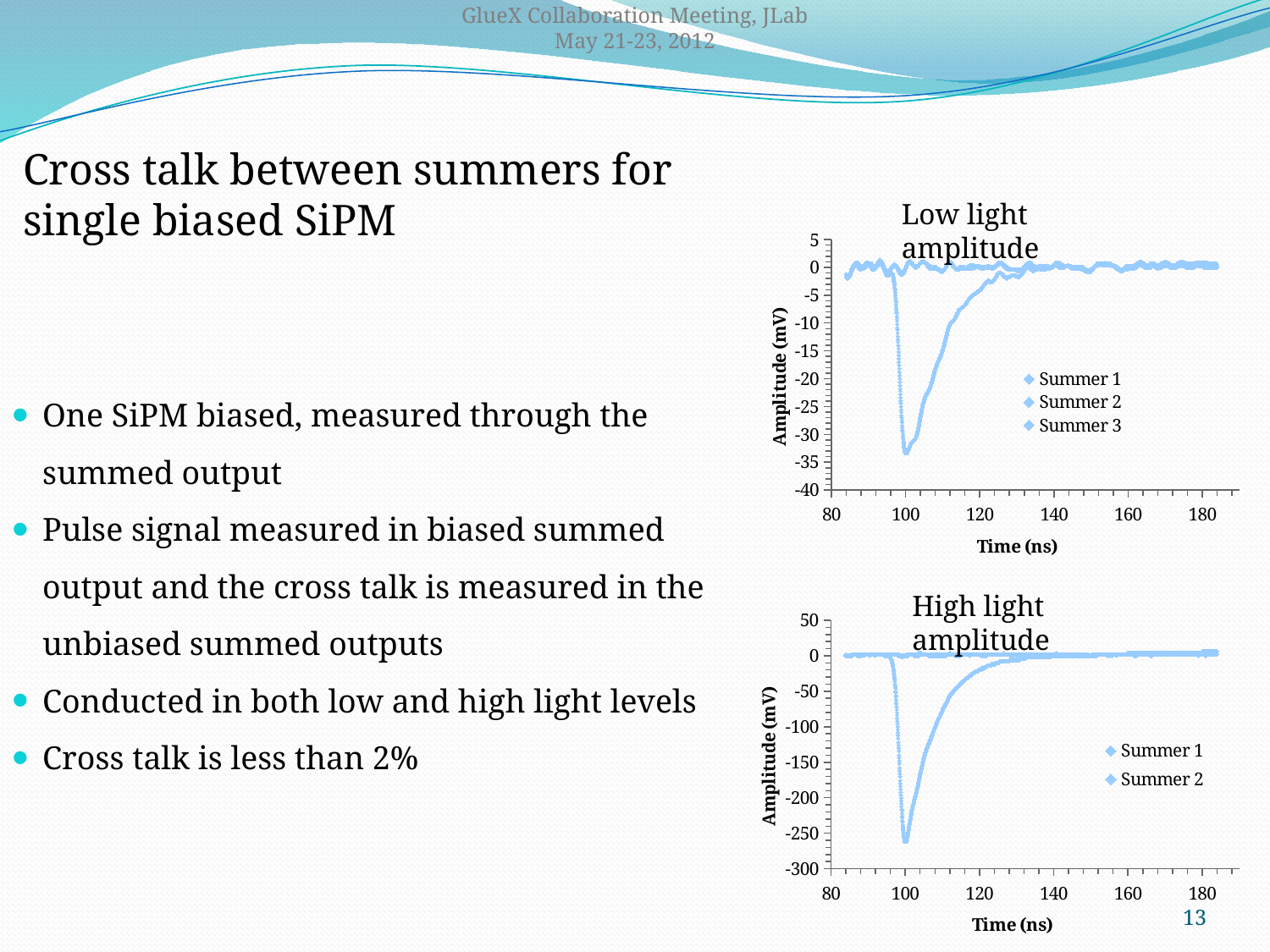
In the "High light amplitude" chart, at roughly what time on the x axis does the pulse reach its minimum: closer to 100 ns or 140 ns? 100 ns What is the x-axis label of the "High light amplitude" chart? Time (ns) In the "Low light amplitude" chart, is the minimum amplitude of the pulse greater or less than -40 mV? greater What is the y-axis label of the "Low light amplitude" chart? Amplitude (mV) In the "Low light amplitude" chart, at roughly what time on the x axis does the pulse reach its minimum: closer to 100 ns or 160 ns? 100 ns What kind of chart is the "Low light amplitude" chart? Scatter chart In the "Low light amplitude" chart, is the minimum amplitude of the pulse greater or less than -20 mV? less How many series does the legend of the "Low light amplitude" chart list? 3 What kind of chart is the "High light amplitude" chart? Scatter chart How many series does the legend of the "High light amplitude" chart list? 2 In the "High light amplitude" chart, is the minimum amplitude of the pulse greater or less than -100 mV? less